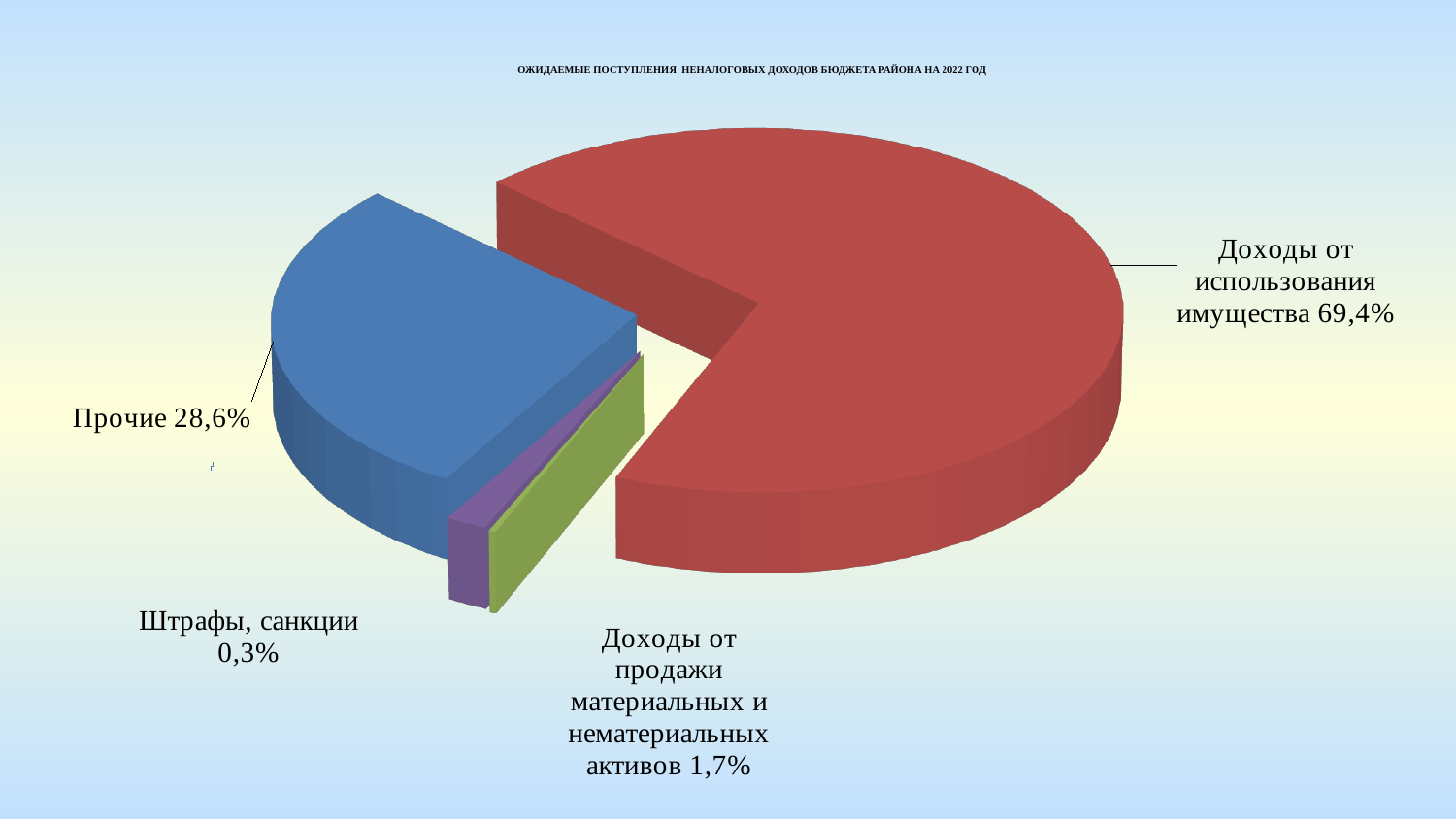
Какова доля категории «Прочие»? 28,6% Что больше: доля «Прочие» или доля «Доходы от продажи материальных и нематериальных активов»? Прочие Какая категория имеет наибольшую долю? Доходы от использования имущества На сколько процентных пунктов доля «Доходы от использования имущества» больше доли «Прочие»? 40,8 Как называется диаграмма на слайде? Ожидаемые поступления неналоговых доходов бюджета района на 2022 год Каким цветом показана категория «Прочие»? Синим Какова доля категории «Доходы от использования имущества»? 69,4% Какой тип диаграммы показан на слайде? Круговая диаграмма Какая категория имеет наименьшую долю? Штрафы, санкции Сколько категорий показано на диаграмме? 4 Какова доля категории «Штрафы, санкции»? 0,3% Какова доля категории «Доходы от продажи материальных и нематериальных активов»? 1,7%